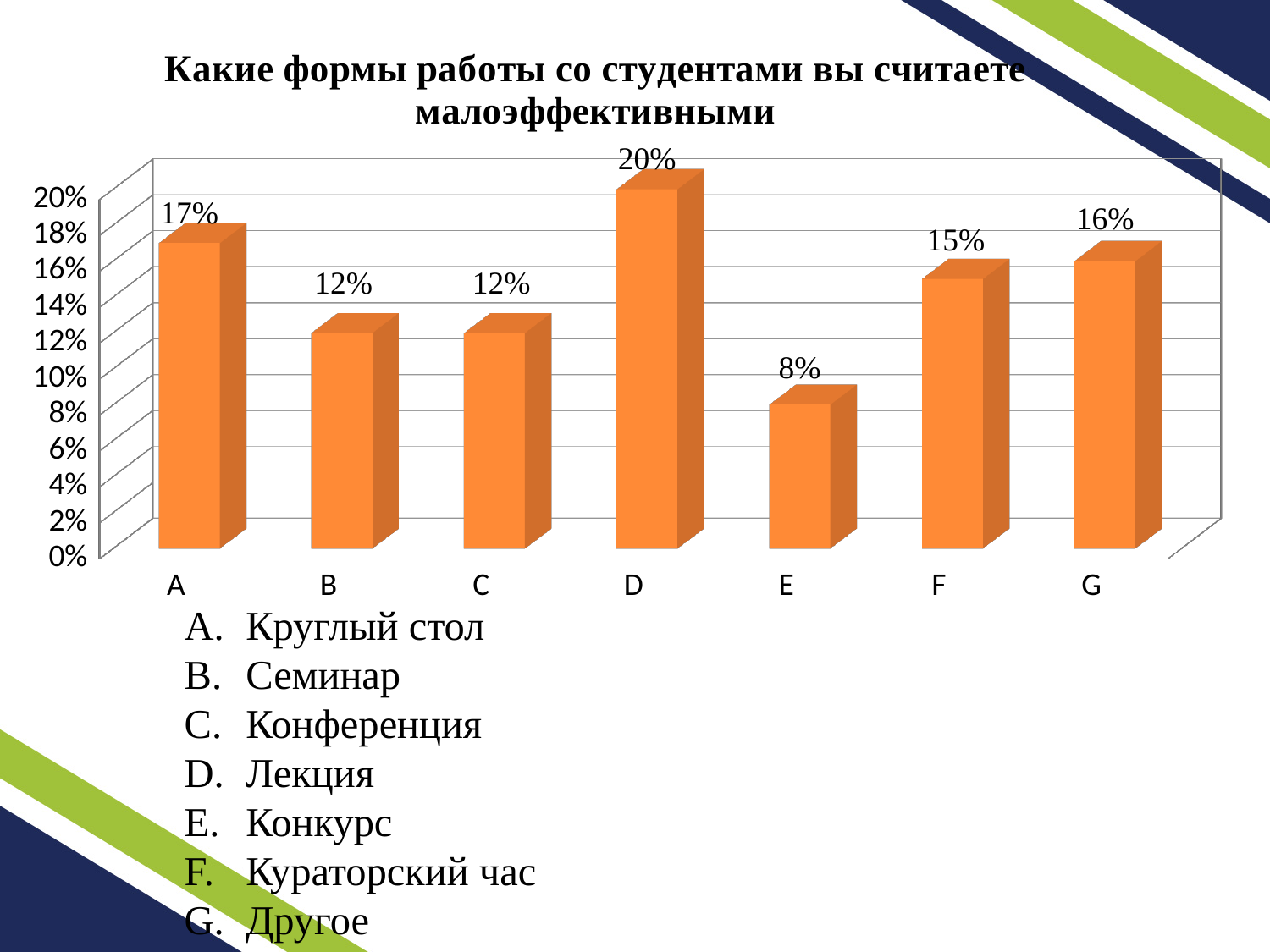
What is the difference between the values for A and G? 1% Which category has the lowest value? E What is the difference between the values for D and E? 12% What is the value for category D? 20% Which is larger, the value for F or the value for B? F What is the value for category F? 15% What kind of chart is shown on the slide? bar chart What is the value for category A? 17% What is the title of the chart? Какие формы работы со студентами вы считаете малоэффективными How many categories are shown on the x axis? 7 Which category has the highest value? D What is the value for category E? 8%